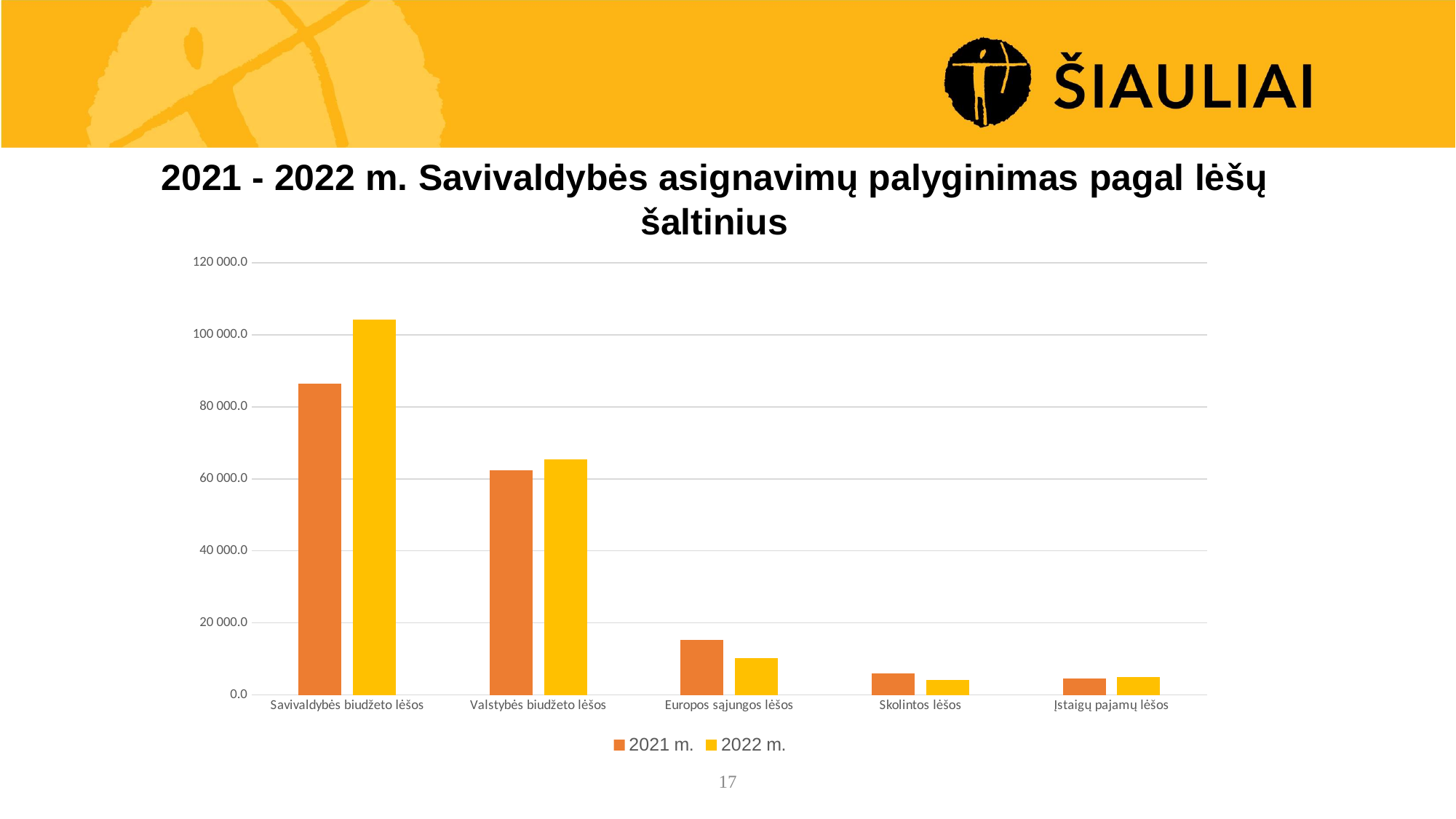
For Savivaldybės biudžeto lėšos, which is larger: the 2021 m. value or the 2022 m. value? 2022 m. Is the 2021 m. value for Savivaldybės biudžeto lėšos greater or less than 80 000.0? greater Which category has the highest value for 2021 m.? Savivaldybės biudžeto lėšos Is the 2022 m. value for Valstybės biudžeto lėšos greater or less than 60 000.0? greater Which category has the highest value for 2022 m.? Savivaldybės biudžeto lėšos Is the 2022 m. value for Savivaldybės biudžeto lėšos greater or less than 100 000.0? greater Which colour represents the 2022 m. series in the legend? yellow What kind of chart is shown on the slide? bar chart For Europos sąjungos lėšos, which is larger: the 2021 m. value or the 2022 m. value? 2021 m. How many series does the legend list? 2 How many categories are shown on the x axis? 5